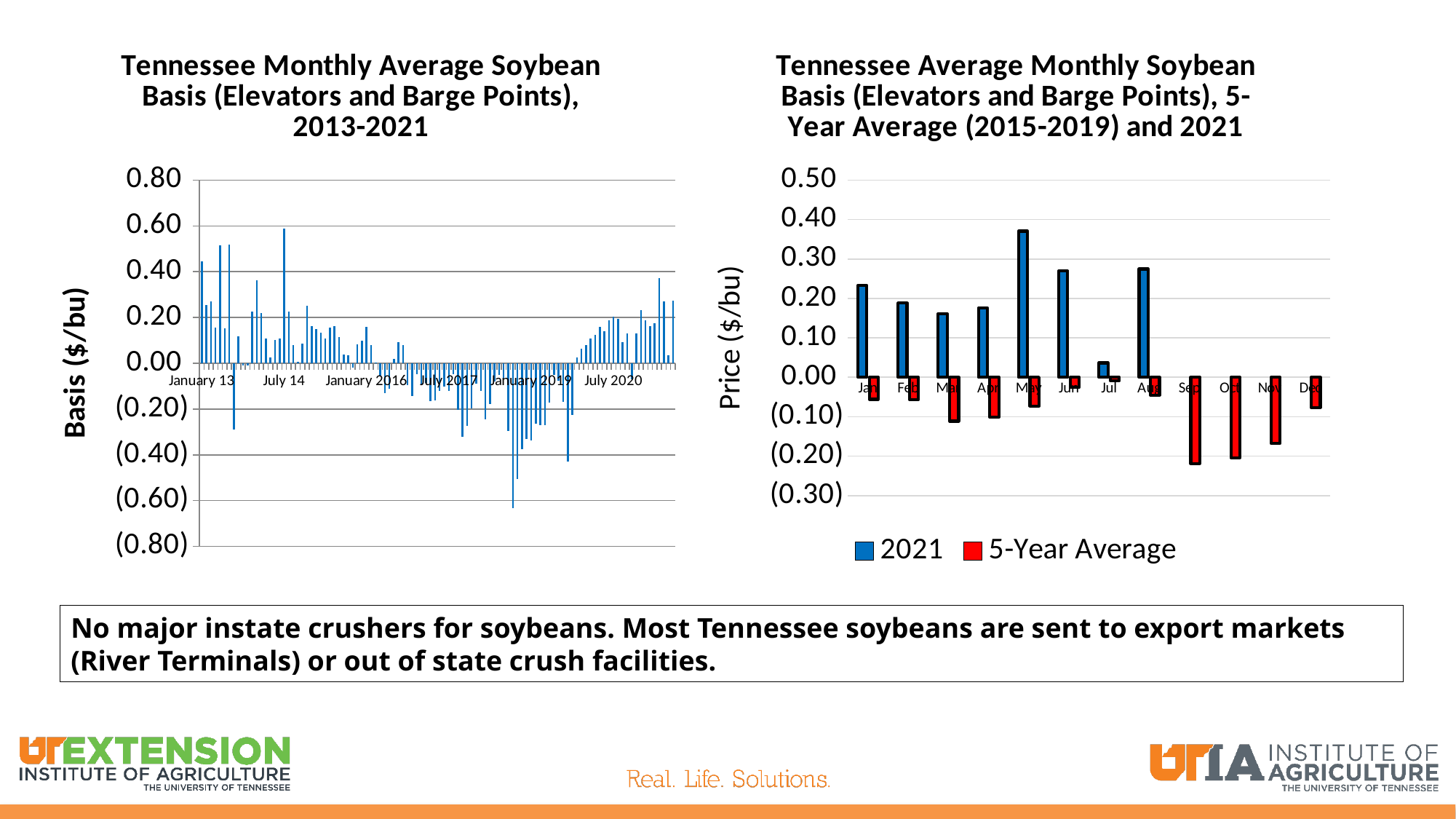
What kind of chart is the left-hand chart, 'Tennessee Monthly Average Soybean Basis (Elevators and Barge Points), 2013-2021'? Bar chart How many series does the legend of the right-hand chart list? 2 In the right-hand chart, which month has the highest 2021 basis? May In the right-hand chart, is the 2021 value for Jul greater or less than 0.10? less In the left-hand chart, is the highest monthly basis value greater or less than 0.40? greater In the right-hand chart, is the 5-Year Average value for Sep greater or less than (0.10)? less What is the y-axis label of the left-hand chart? Basis ($/bu) How many months are shown on the x axis of the right-hand chart? 12 In the right-hand chart, which colour represents the 5-Year Average series? Red In the right-hand chart, which is larger: the 2021 value for Jan or the 2021 value for Feb? Jan What kind of chart is the right-hand chart, 'Tennessee Average Monthly Soybean Basis (Elevators and Barge Points), 5-Year Average (2015-2019) and 2021'? Bar chart